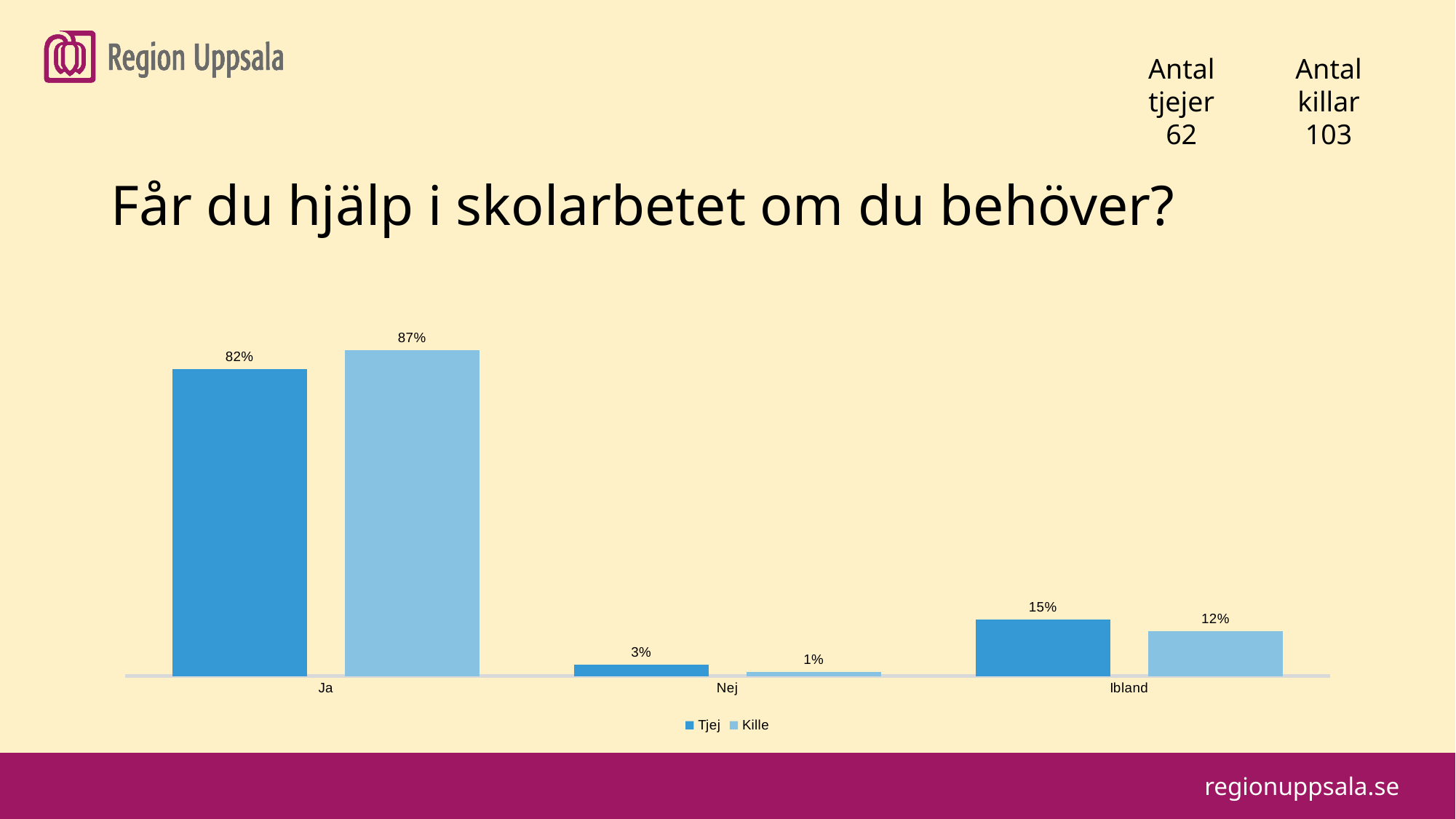
What is the value for Kille in the Ibland category? 12% In the Nej category, which series has the larger value, Tjej or Kille? Tjej What is the difference between the Kille and Tjej values in the Ja category? 5% How many categories are shown on the x axis? 3 What is the value for Tjej in the Nej category? 3% What is the value for Tjej in the Ja category? 82% How many series does the legend list? 2 Which category has the highest value for Kille? Ja What is the value for Kille in the Ja category? 87% What kind of chart is shown on the slide? Bar chart Which category has the lowest value for Tjej? Nej What is the difference between the Tjej and Kille values in the Ibland category? 3%